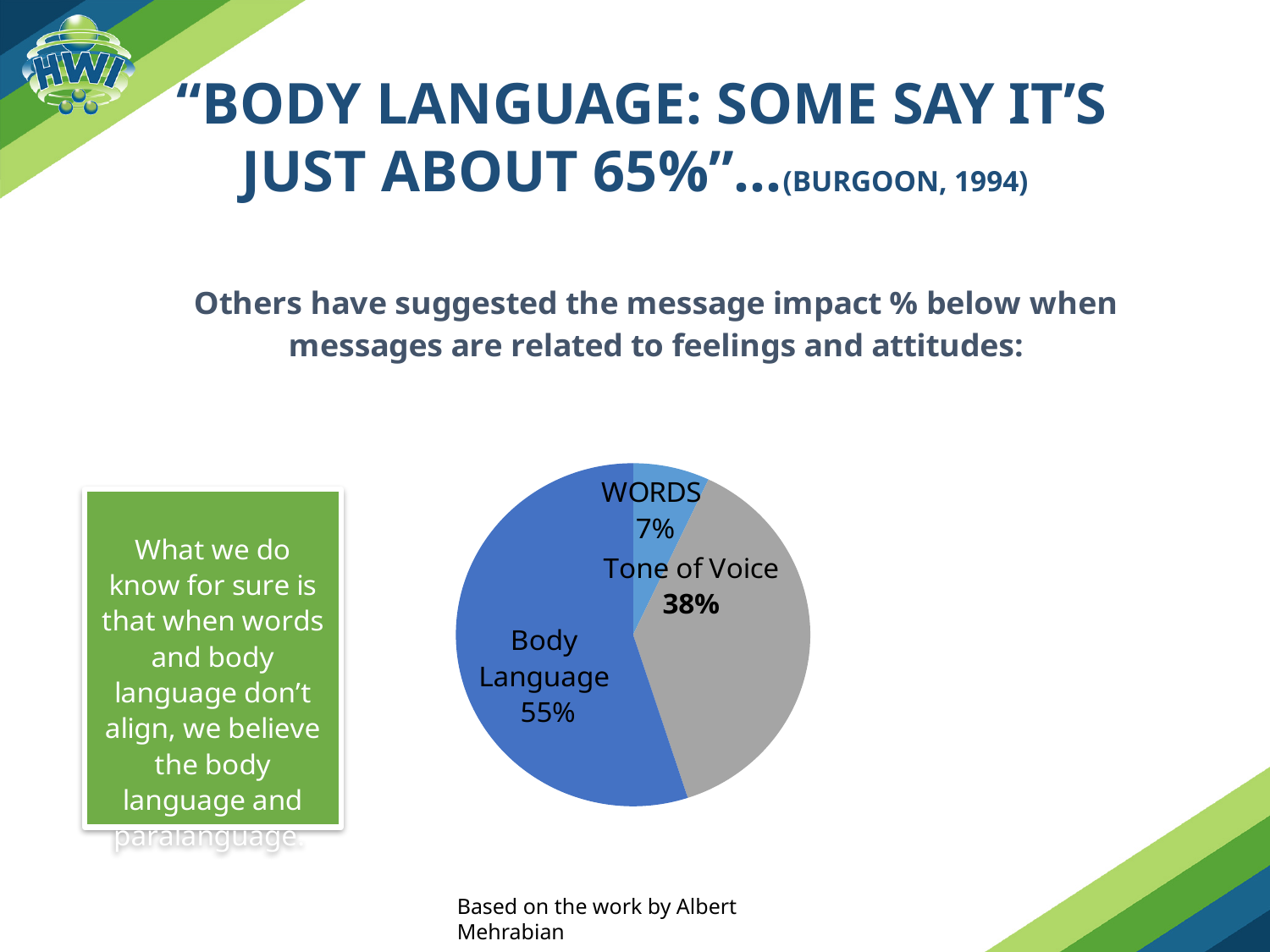
What is the difference in percentage points between Body Language and Tone of Voice? 17 Which slice of the pie chart is the smallest? WORDS What percentage does the pie chart show for WORDS? 7% What is the difference in percentage points between Tone of Voice and WORDS? 31 How many slices does the pie chart have? 3 What kind of chart is shown on the slide? pie chart Which is larger in the pie chart, Tone of Voice or WORDS? Tone of Voice What percentage does the pie chart show for Body Language? 55% What colour is the Body Language slice of the pie chart? blue What colour is the Tone of Voice slice of the pie chart? grey What percentage does the pie chart show for Tone of Voice? 38% Which slice of the pie chart is the largest? Body Language